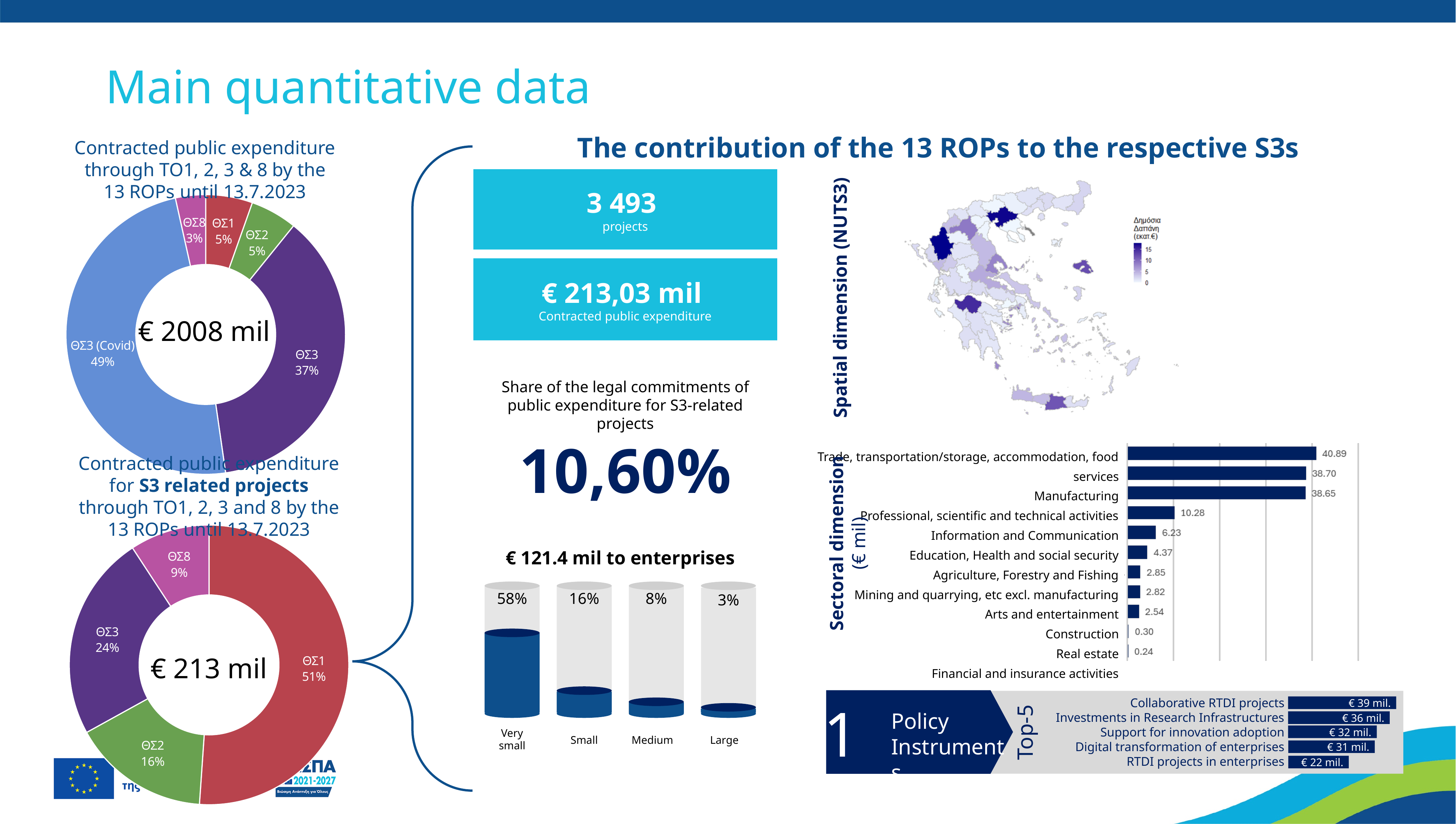
In the bottom-left donut chart (Contracted public expenditure for S3 related projects), what is the difference between the shares of ΘΣ3 and ΘΣ2? 8% In the top-left donut chart (Contracted public expenditure through TO1, 2, 3 & 8), what total amount is shown in the centre? € 2008 mil In the '€ 121.4 mil to enterprises' chart, what percentage goes to Very small enterprises? 58% In the Top-5 Policy Instruments chart, what amount is shown for Collaborative RTDI projects? € 39 mil. In the Sectoral dimension (€ mil) chart, what is the highest value shown on a bar? 40.89 In the '€ 121.4 mil to enterprises' chart, which enterprise size has the lowest percentage? Large In the top-left donut chart (Contracted public expenditure through TO1, 2, 3 & 8), which category has the smallest share? ΘΣ8 In the top-left donut chart (Contracted public expenditure through TO1, 2, 3 & 8), what share does ΘΣ3 (Covid) have? 49% In the '€ 121.4 mil to enterprises' chart, do the percentages rise or fall from Very small to Large? fall In the bottom-left donut chart (Contracted public expenditure for S3 related projects), what share does ΘΣ1 have? 51% In the bottom-left donut chart (Contracted public expenditure for S3 related projects), which category has the largest share? ΘΣ1 In the bottom-left donut chart (Contracted public expenditure for S3 related projects), how many categories are shown? 4